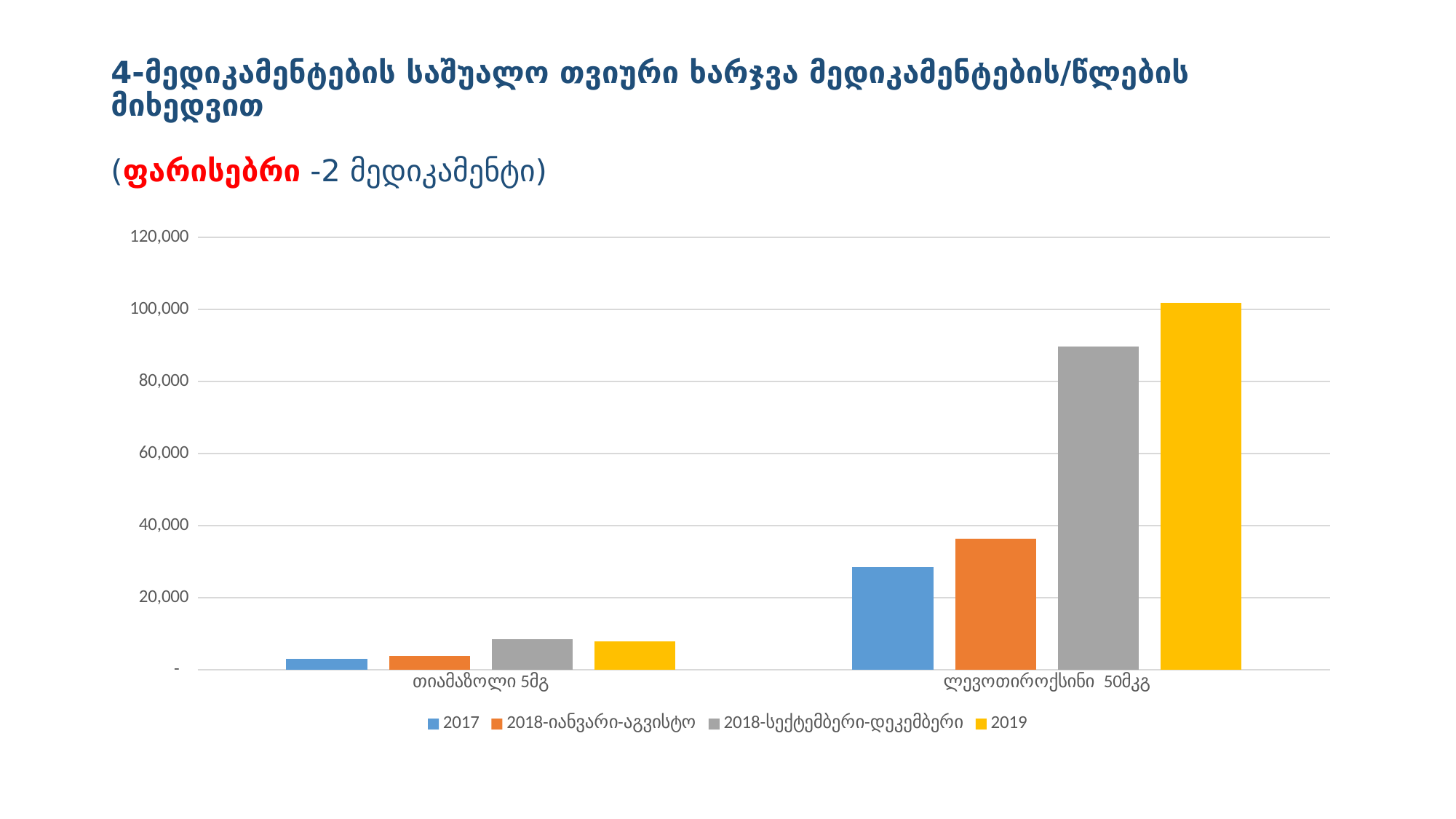
Which category has the larger value for 2019: თიამაზოლი 5მგ or ლევოთიროქსინი 50მკგ? ლევოთიროქსინი 50მკგ How many series does the chart's legend list? 4 Which series has the lowest value for თიამაზოლი 5მგ? 2017 Is the value for ლევოთიროქსინი 50მკგ in 2019 greater or less than 100,000? greater Is the value for ლევოთიროქსინი 50მკგ in 2018-სექტემბერი-დეკემბერი greater or less than 80,000? greater What kind of chart is shown on the slide? bar chart For ლევოთიროქსინი 50მკგ, which is larger: the 2017 value or the 2018-იანვარი-აგვისტო value? 2018-იანვარი-აგვისტო What colour represents the 2019 series in the chart? yellow Is the value for თიამაზოლი 5მგ in 2019 greater or less than 20,000? less Which series has the highest value for ლევოთიროქსინი 50მკგ? 2019 How many categories are shown on the x axis of the chart? 2